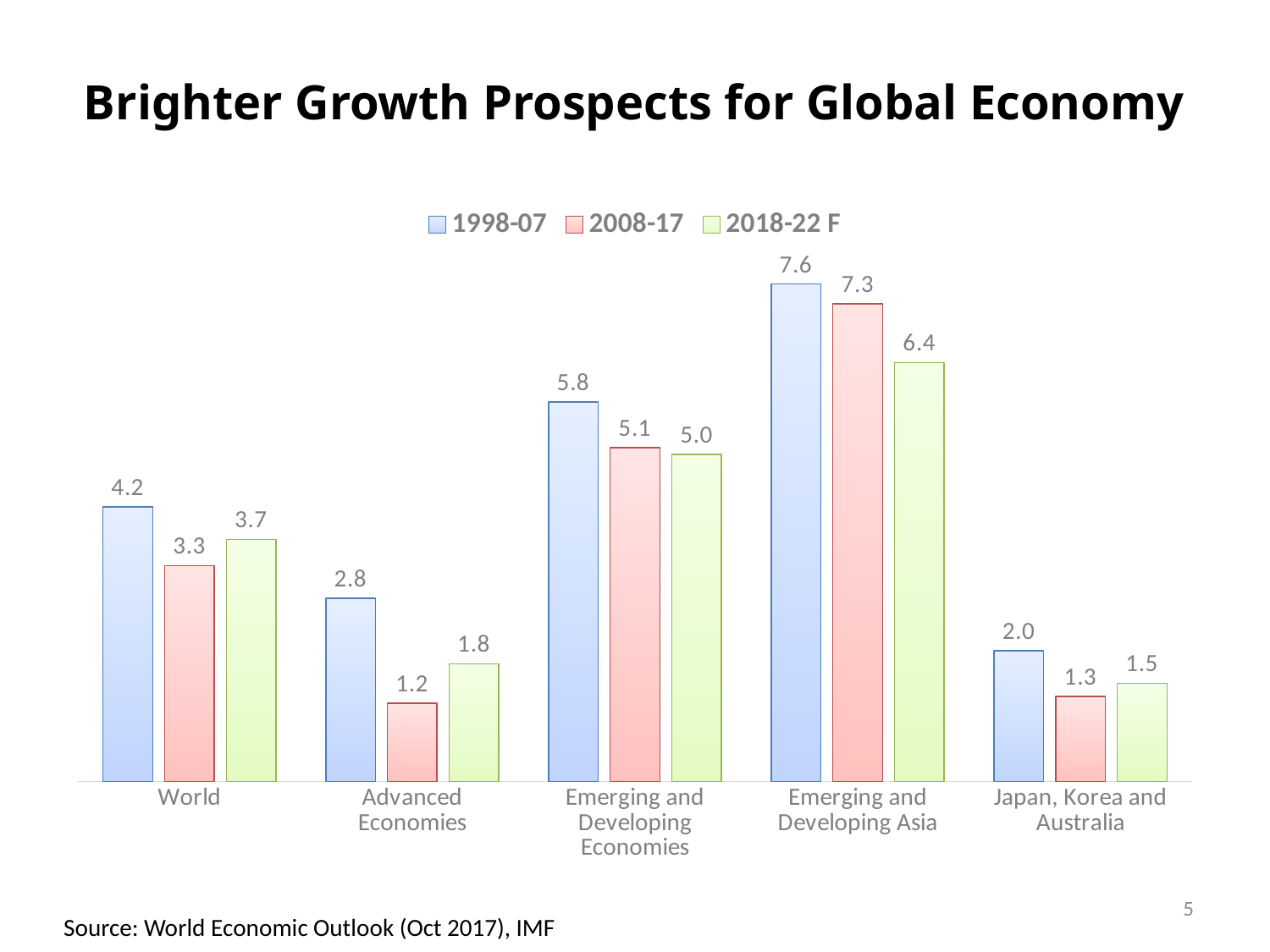
Which category has the highest value in the 1998-07 series? Emerging and Developing Asia How many series does the legend list? 3 For Emerging and Developing Economies, do the values rise or fall from 1998-07 to 2018-22 F? Fall How many categories are shown on the x axis? 5 What is the 2018-22 F value for Emerging and Developing Asia? 6.4 What is the difference between the 1998-07 and 2018-22 F values for Emerging and Developing Asia? 1.2 What is the value for Advanced Economies in the 2008-17 series? 1.2 Which is larger for Advanced Economies: the 2008-17 value or the 2018-22 F value? 2018-22 F Which category has the lowest value in the 2008-17 series? Advanced Economies What is the value for World in the 1998-07 series? 4.2 What kind of chart is shown on the slide? Bar chart What is the 2008-17 value for Japan, Korea and Australia? 1.3